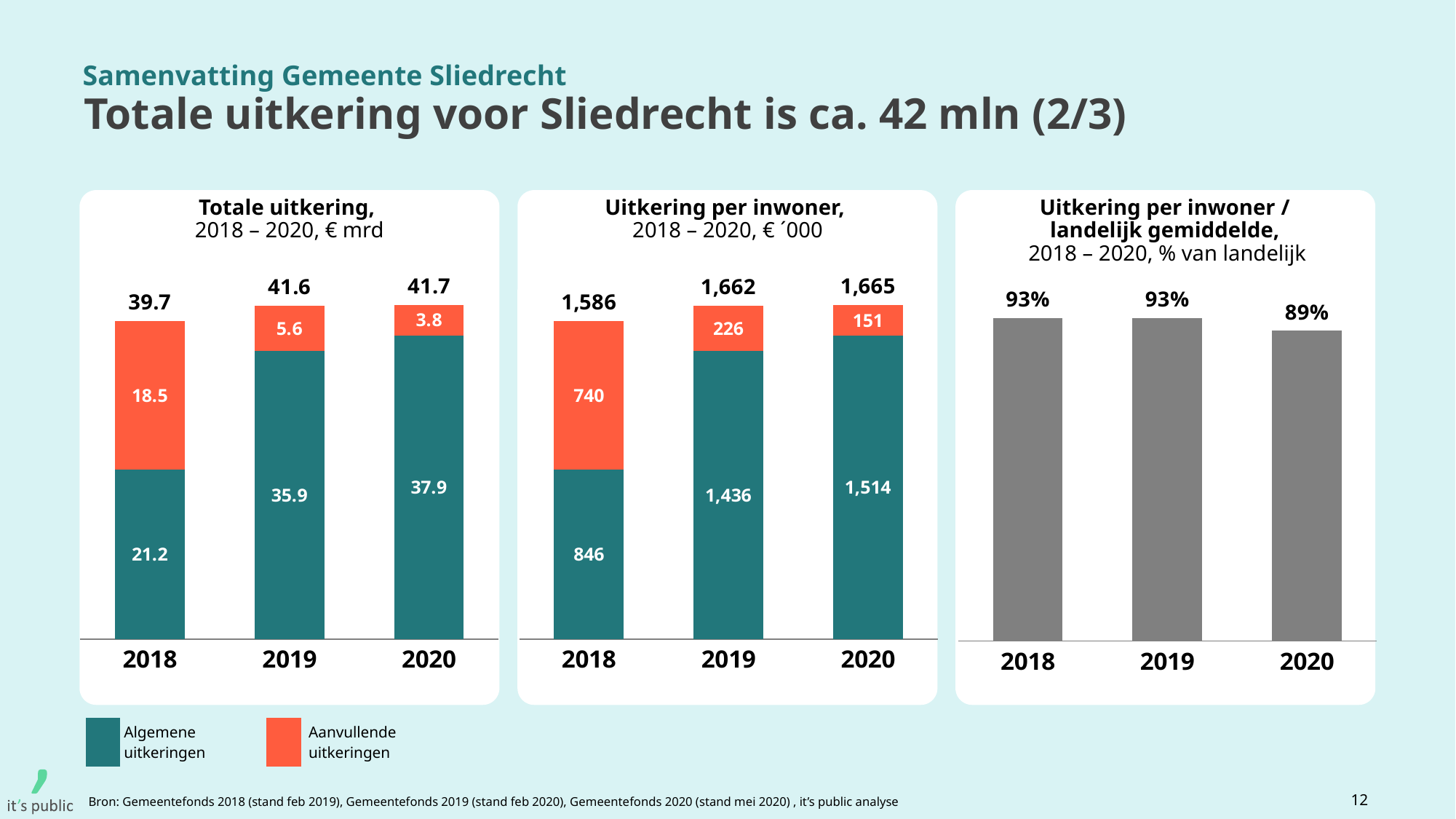
In the chart 'Uitkering per inwoner, 2018 – 2020, € ´000', what is the value of Aanvullende uitkeringen for 2019? 226 In the chart 'Totale uitkering, 2018 – 2020, € mrd', what is the total of the stacked bar for 2020? 41.7 In the chart 'Uitkering per inwoner / landelijk gemiddelde', what is the value for 2020? 89% In the chart 'Uitkering per inwoner, 2018 – 2020, € ´000', what is the difference between the totals for 2020 and 2018? 79 In the chart 'Uitkering per inwoner / landelijk gemiddelde', which year has the lowest value? 2020 In the chart 'Totale uitkering, 2018 – 2020, € mrd', which year has the lowest total? 2018 How many series does the legend at the bottom of the slide list? 2 In the chart 'Uitkering per inwoner, 2018 – 2020, € ´000', what is the total of the stacked bar for 2018? 1,586 What kind of chart is 'Uitkering per inwoner / landelijk gemiddelde'? bar chart In the chart 'Totale uitkering, 2018 – 2020, € mrd', what is the value of Algemene uitkeringen for 2018? 21.2 In the chart 'Totale uitkering, 2018 – 2020, € mrd', what is the difference between the Aanvullende uitkeringen values for 2018 and 2020? 14.7 In the chart 'Uitkering per inwoner, 2018 – 2020, € ´000', which is larger: Algemene uitkeringen in 2018 or in 2020? 2020